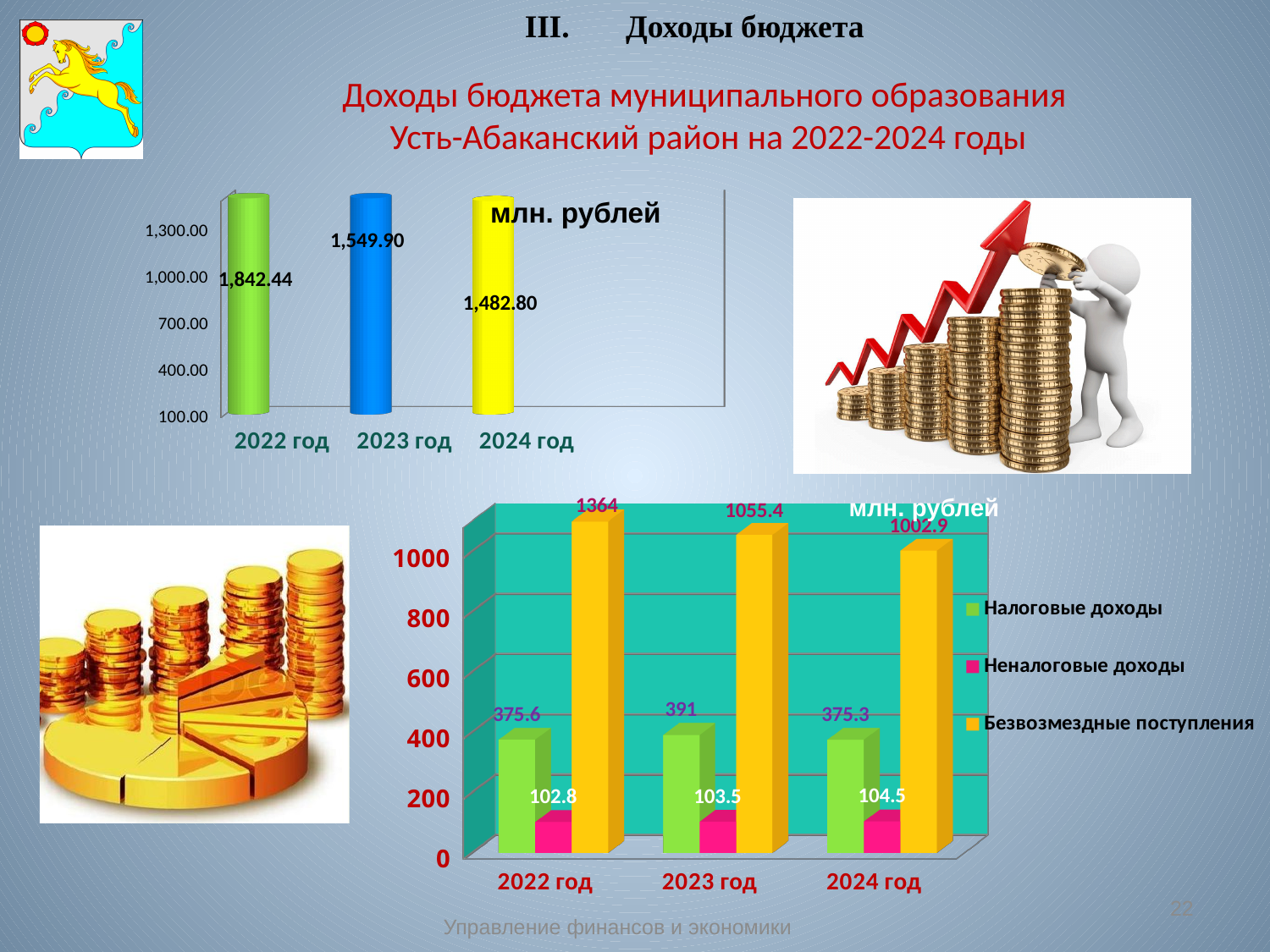
In the top-left chart, how many years are shown? 3 In the bottom chart, which is larger for 2023 год: Налоговые доходы or Неналоговые доходы? Налоговые доходы In the top-left chart, what unit is stated for the values? млн. рублей In the top-left chart, which year has the highest value? 2022 год In the bottom chart, what kind of chart is it? bar chart In the bottom chart, what is the value of Налоговые доходы for 2023 год? 391 In the bottom chart, do the values of Безвозмездные поступления rise or fall from 2022 год to 2024 год? fall In the top-left chart, what is the value for 2022 год? 1,842.44 In the bottom chart, what is the value of Безвозмездные поступления for 2022 год? 1364 In the bottom chart, what is the value of Неналоговые доходы for 2024 год? 104.5 In the bottom chart, how many series does the legend list? 3 In the top-left chart, what is the value for 2024 год? 1,482.80